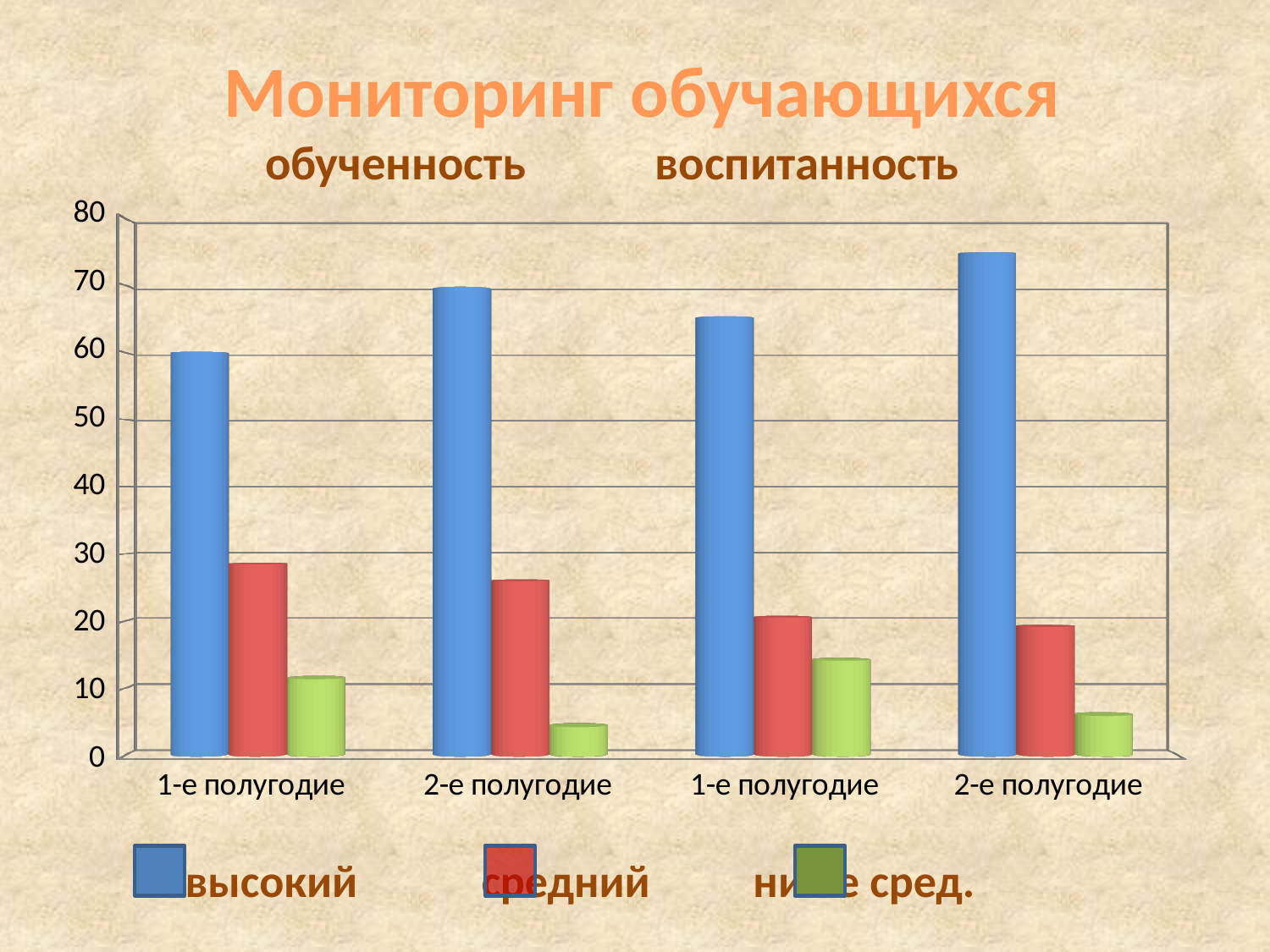
How many categories are shown along the x axis? 4 What are the three legend entries of the chart? высокий, средний, ниже сред. Is the 'высокий' value for 2-е полугодие under обученность greater or less than 60? greater Under обученность, does the 'высокий' value rise or fall from 1-е полугодие to 2-е полугодие? rises Is the 'ниже сред.' value for 1-е полугодие under обученность greater or less than 20? less What colour represents the 'высокий' series? blue Which category has the lowest 'ниже сред.' bar? 2-е полугодие (обученность) Is the 'средний' value for 1-е полугодие under воспитанность greater or less than 30? less Which category has the highest 'высокий' bar? 2-е полугодие (воспитанность) What kind of chart is shown on the slide? bar chart Which is larger: the 'высокий' bar for 1-е полугодие under обученность or the 'высокий' bar for 1-е полугодие under воспитанность? 1-е полугодие under воспитанность How many series does the legend list? 3